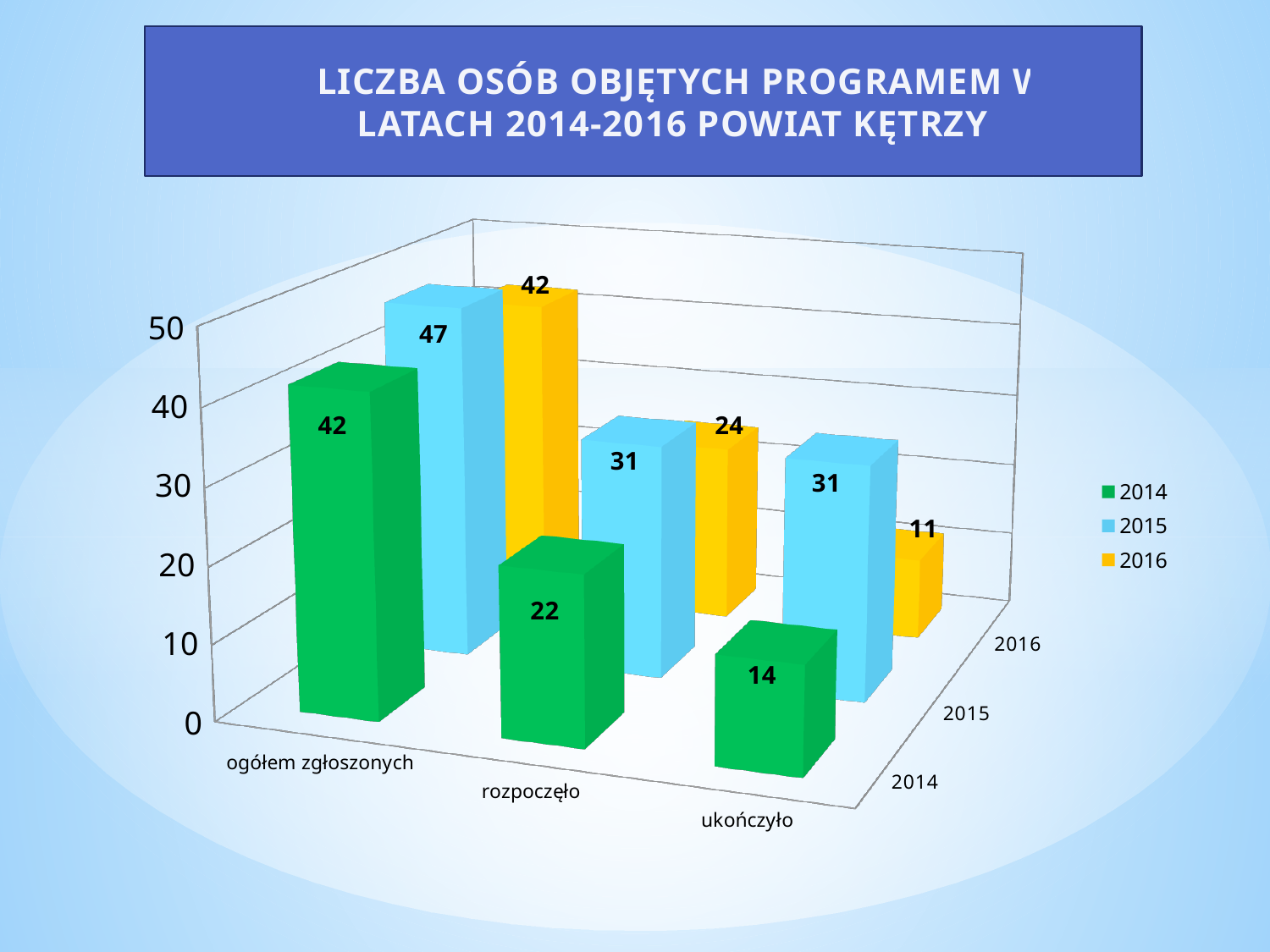
What kind of chart is shown on the slide? bar chart What is the value for 2015 in the category 'ogółem zgłoszonych'? 47 Which is larger: the 2016 value for 'ogółem zgłoszonych' or the 2016 value for 'rozpoczęło'? ogółem zgłoszonych How many series does the legend list? 3 What is the title of the chart? LICZBA OSÓB OBJĘTYCH PROGRAMEM V LATACH 2014-2016 POWIAT KĘTRZY What is the difference between the 2015 and 2014 values in the category 'rozpoczęło'? 9 Which year has the highest value in the category 'ogółem zgłoszonych'? 2015 What is the value for 2014 in the category 'ukończyło'? 14 What is the value for 2016 in the category 'rozpoczęło'? 24 For the 2014 series, do the values rise or fall from 'ogółem zgłoszonych' to 'ukończyło'? fall How many categories are shown on the x axis? 3 Which year has the lowest value in the category 'ukończyło'? 2016